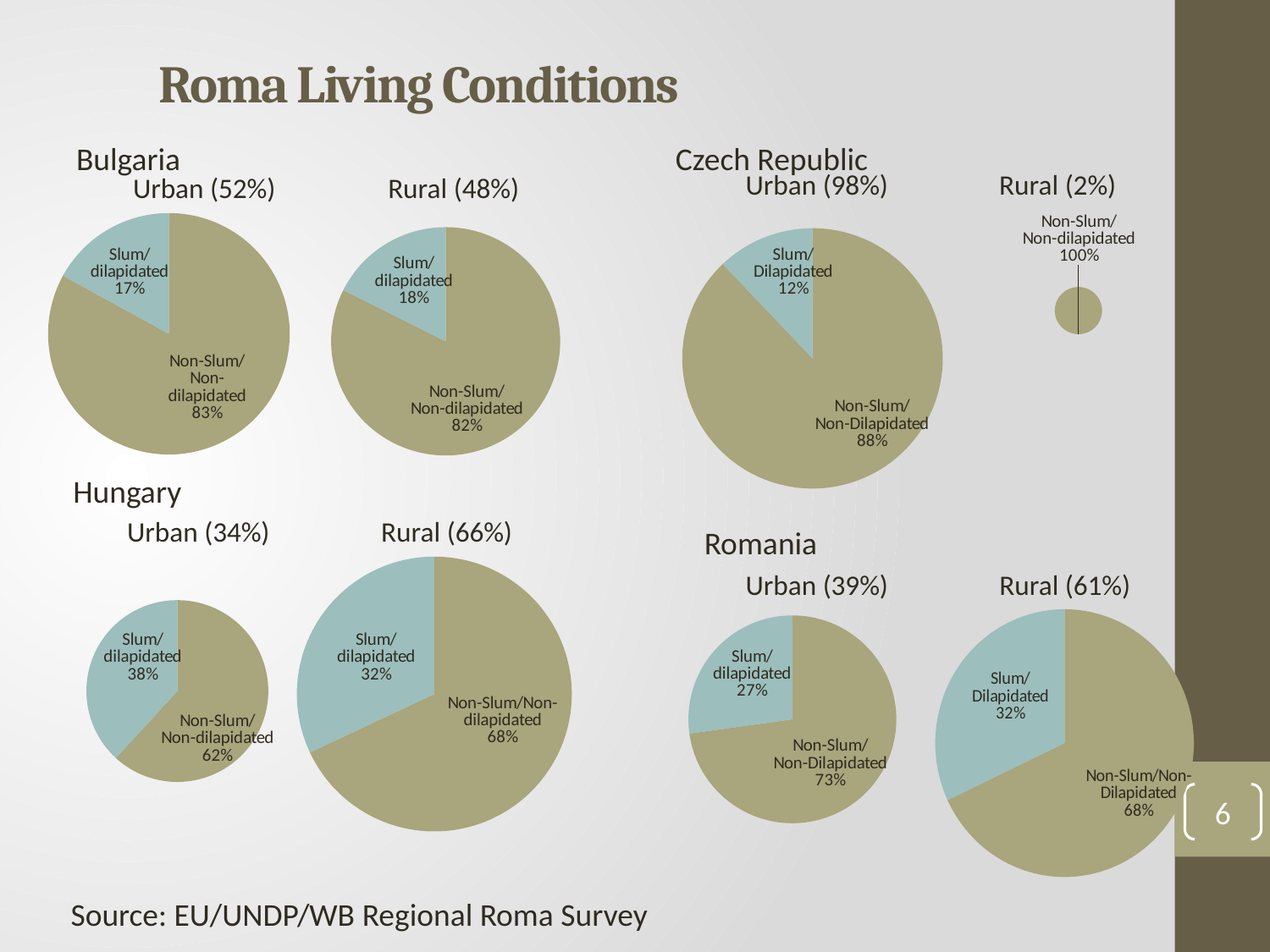
In the Hungary Urban pie chart, what is the difference between the Non-Slum/Non-dilapidated share and the Slum/dilapidated share? 24% How many slices does the Czech Republic Rural pie chart have? 1 In the Hungary Rural pie chart, what share is Non-Slum/Non-dilapidated? 68% What kind of chart is used for the Bulgaria Urban data? Pie chart In the Romania Rural pie chart, which slice is larger, Slum/Dilapidated or Non-Slum/Non-Dilapidated? Non-Slum/Non-Dilapidated In the Bulgaria Rural pie chart, what share is Non-Slum/Non-dilapidated? 82% In the Hungary Urban pie chart, what share is Slum/dilapidated? 38% What is the title of the slide containing these pie charts? Roma Living Conditions In the Czech Republic Urban pie chart, what share is Slum/Dilapidated? 12% In the Romania Urban pie chart, what share is Slum/dilapidated? 27% In the Czech Republic Rural pie chart, what share is Non-Slum/Non-dilapidated? 100% In the Bulgaria Urban pie chart, what share is Slum/dilapidated? 17%